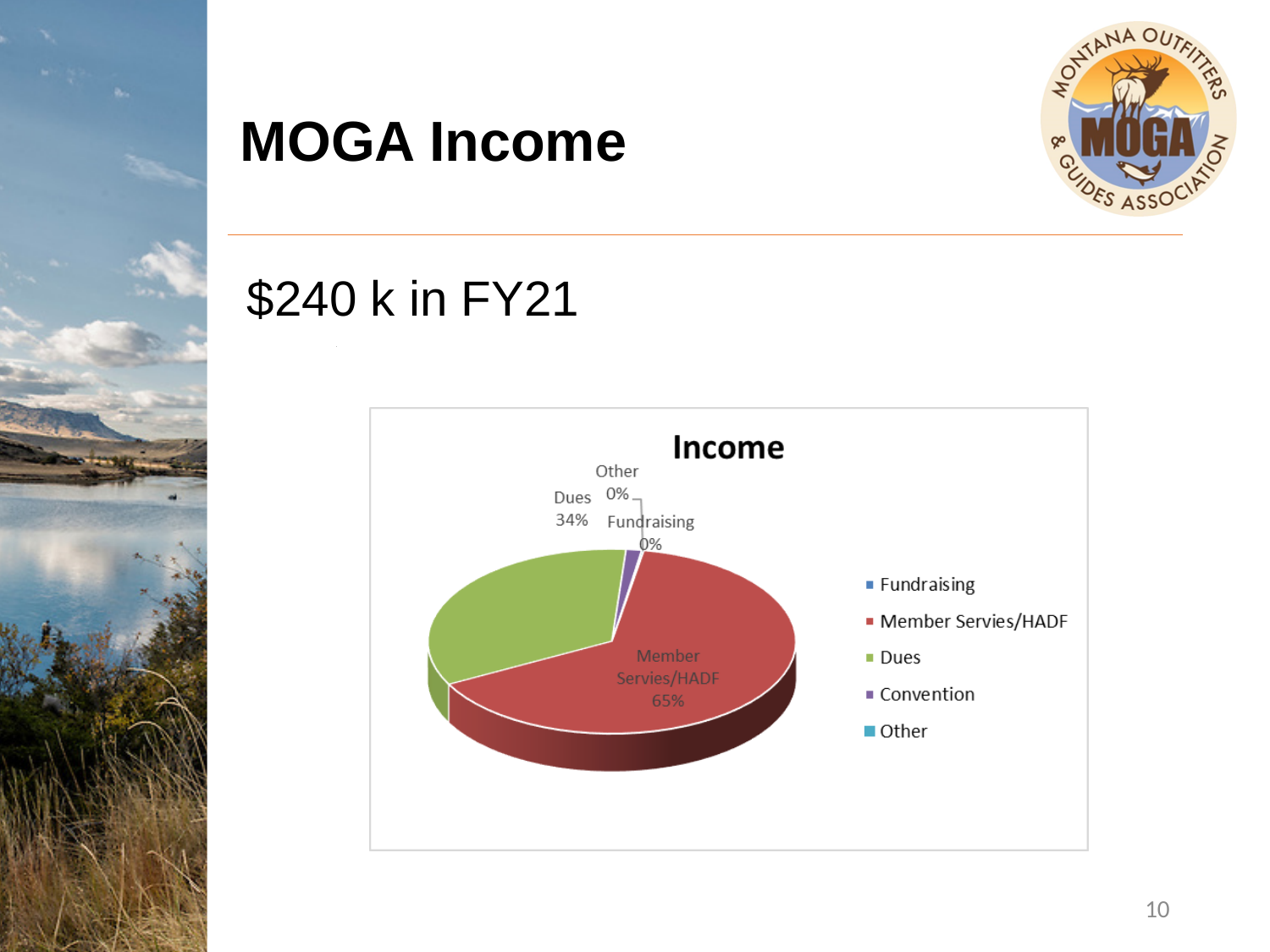
Which is larger, the share for Dues or the share for Member Servies/HADF? Member Servies/HADF What kind of chart is shown on the slide? pie chart How many percentage points larger is the Member Servies/HADF share than the Dues share? 31 percentage points What percentage of income does Member Servies/HADF account for? 65% What is the title of the chart? Income What percentage of income comes from Dues? 34% What percentage is shown for Fundraising? 0% What percentage is shown for Other? 0% How many categories does the legend list? 5 Which category makes up the largest share of income? Member Servies/HADF What colour is the Dues slice of the pie? green